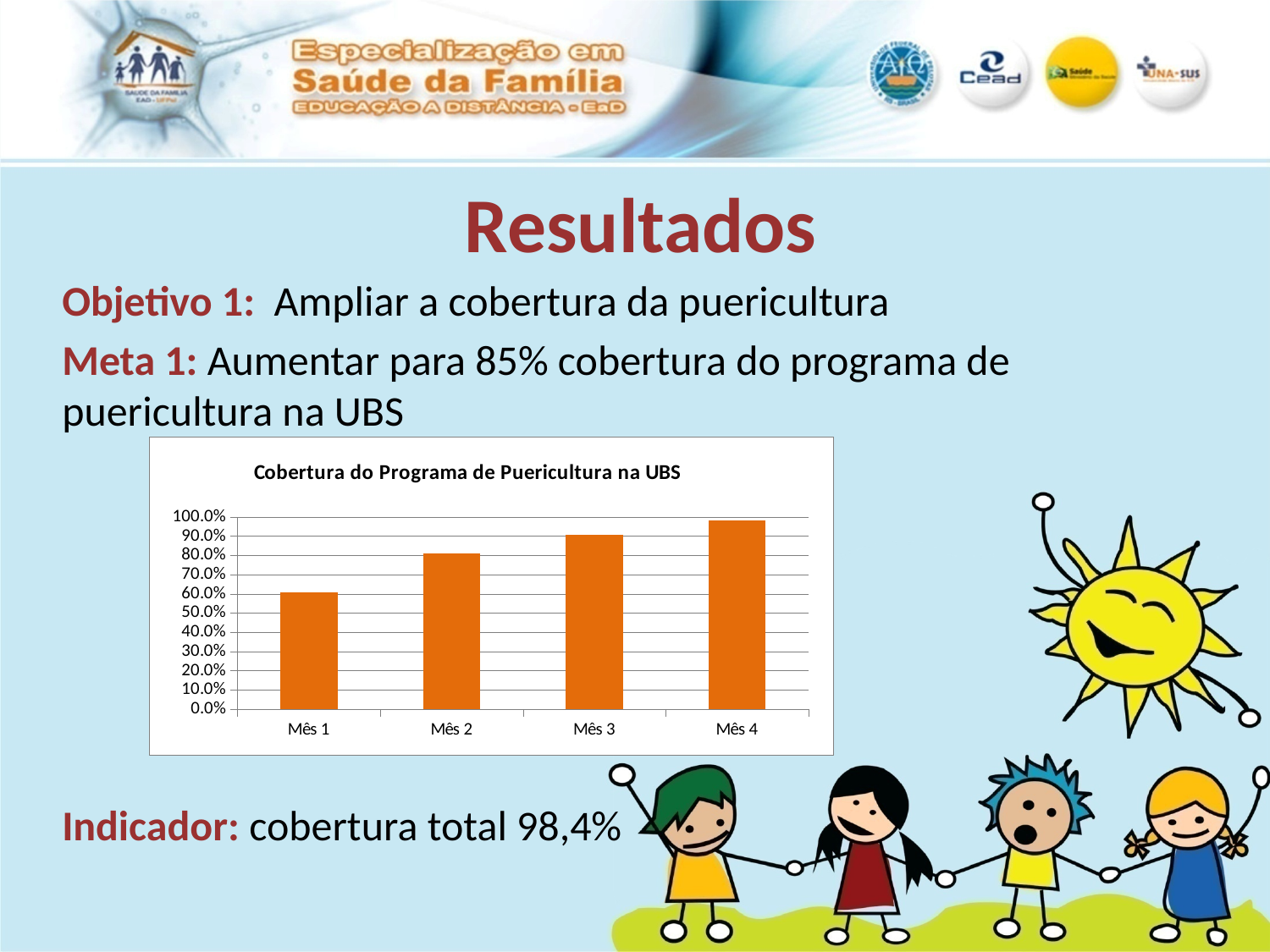
Which month has the highest coverage in the chart? Mês 4 Which is larger, the value for Mês 1 or the value for Mês 2? Mês 2 What is the title of the chart? Cobertura do Programa de Puericultura na UBS Is the value for Mês 2 greater or less than 70.0%? greater Is the value for Mês 4 greater or less than 90.0%? greater Is the value for Mês 1 greater or less than 70.0%? less How many categories (months) are plotted on the x axis of the chart? 4 Do the coverage values rise or fall from Mês 1 to Mês 4? rise What type of chart is shown on the slide? bar chart What colour are the bars in the chart? orange Which month has the lowest coverage in the chart? Mês 1